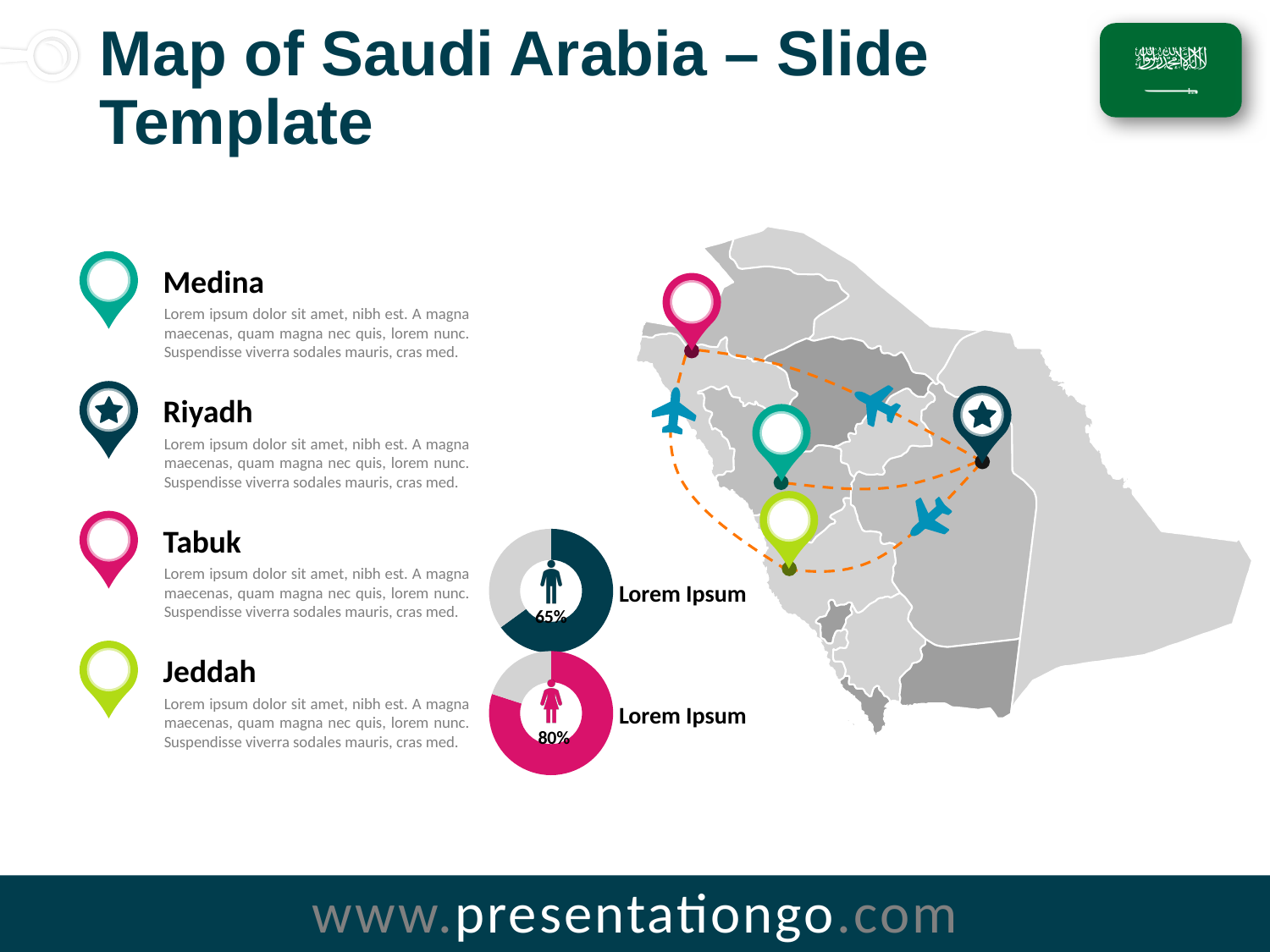
What kind of chart is the lower chart with the female figure icon? donut chart How many donut charts are shown on the slide? 2 What kind of chart is the upper chart with the male figure icon? donut chart What colour is the filled portion of the lower donut chart showing 80%? pink In the upper donut chart with the male figure icon, what percentage is shown? 65% What is the difference between the percentage in the lower donut chart (80%) and the upper donut chart (65%)? 15% What colour is the filled portion of the upper donut chart showing 65%? dark teal In the lower donut chart with the female figure icon, what percentage is shown? 80% What label appears to the right of the lower donut chart showing 80%? Lorem Ipsum Is the value shown in the upper donut chart with the male icon greater or less than 50%? greater Which donut chart shows the larger percentage, the upper one with the male icon or the lower one with the female icon? the lower one with the female icon